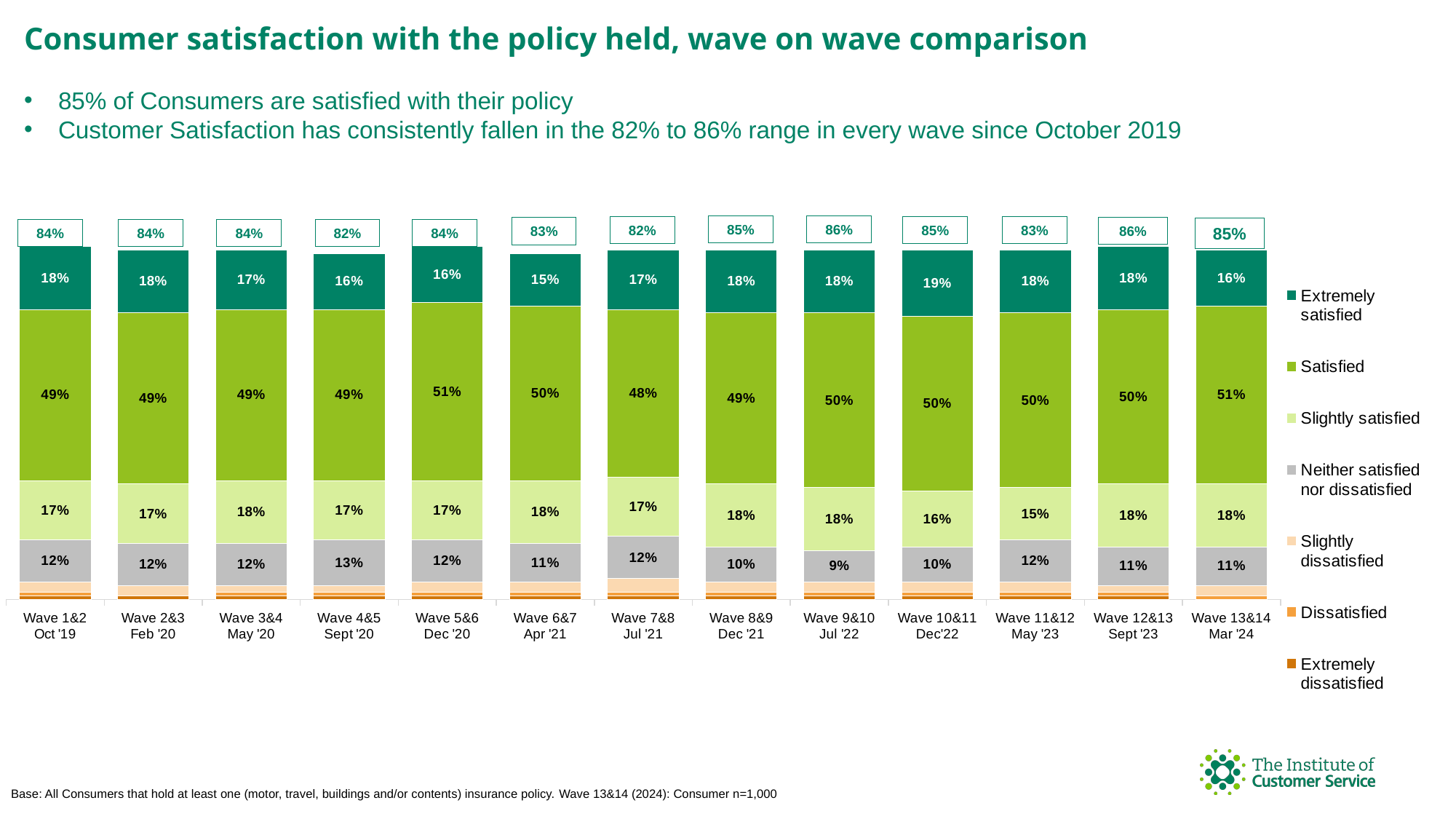
What is the title of the chart on the slide? Consumer satisfaction with the policy held, wave on wave comparison Which wave has the lowest 'Extremely satisfied' value? Wave 6&7 Apr '21 Which is larger: the 'Slightly satisfied' value for Wave 11&12 May '23 or for Wave 12&13 Sept '23? Wave 12&13 Sept '23 How many series does the legend list? 7 What kind of chart is shown on the slide? Stacked bar chart How many waves (bars) are shown on the chart? 13 What is the 'Extremely satisfied' value for Wave 10&11 Dec'22? 19% What is the 'Satisfied' value for Wave 7&8 Jul '21? 48% What overall satisfaction percentage is shown above the bar for Wave 13&14 Mar '24? 85% Which wave has the highest 'Extremely satisfied' value? Wave 10&11 Dec'22 What is the difference between the 'Satisfied' values for Wave 13&14 Mar '24 and Wave 7&8 Jul '21? 3% What is the 'Neither satisfied nor dissatisfied' value for Wave 9&10 Jul '22? 9%